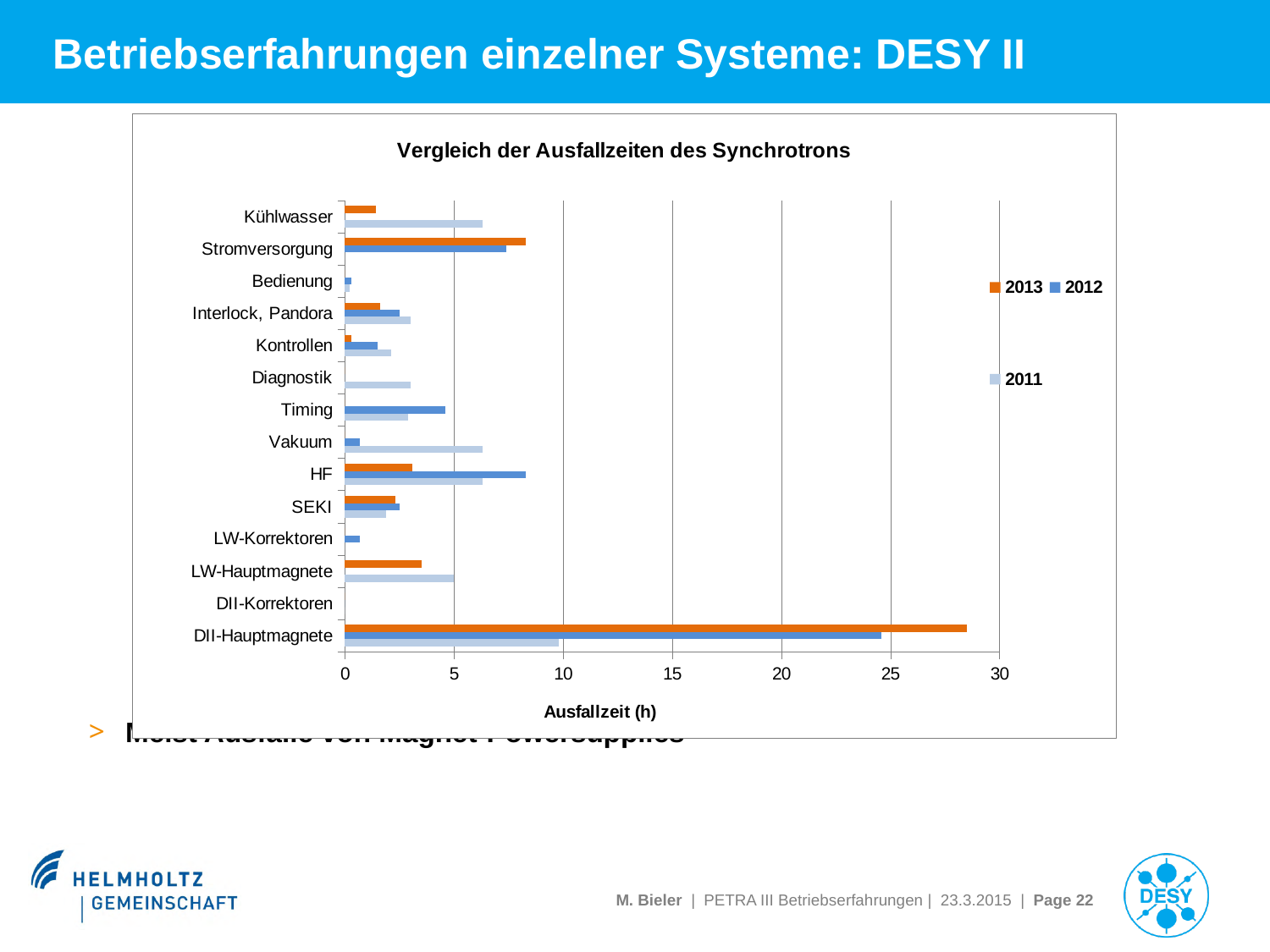
Is the 2013 value for Stromversorgung greater or less than 5? greater Which category has the highest value for 2013? DII-Hauptmagnete Is the 2012 value for DII-Hauptmagnete greater or less than 20? greater What is the label of the horizontal axis? Ausfallzeit (h) Is the 2013 value for DII-Hauptmagnete greater or less than 25? greater What kind of chart is shown on the slide? bar chart For 2013, which category has the larger value, Stromversorgung or Kühlwasser? Stromversorgung Which category has the highest value for 2012? DII-Hauptmagnete For HF, which year has the larger value, 2012 or 2013? 2012 What is the title of the chart? Vergleich der Ausfallzeiten des Synchrotrons How many series does the legend list? 3 How many categories are shown on the vertical axis? 14